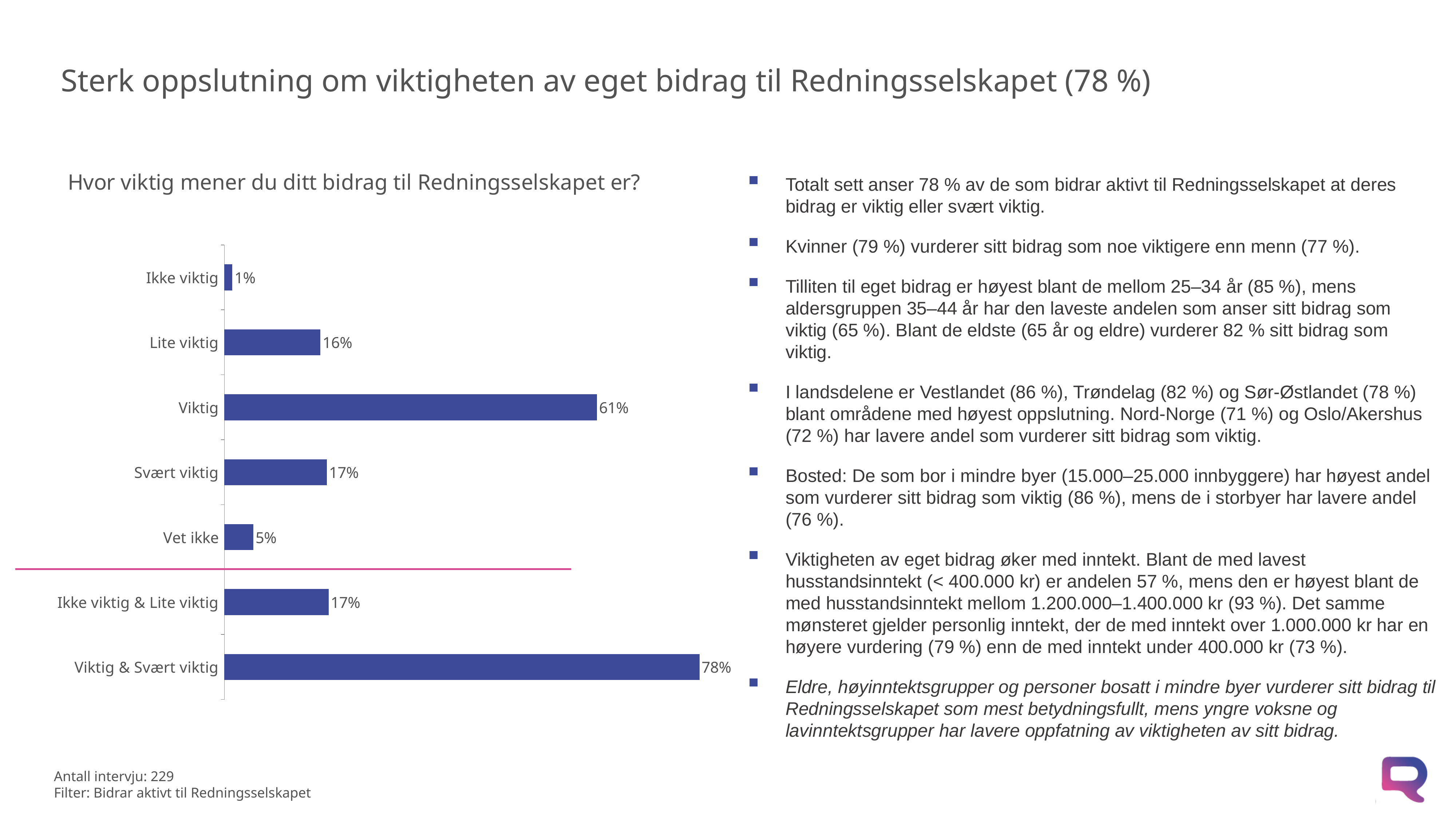
What is the value for "Lite viktig"? 16% What kind of chart is shown on the slide? Bar chart What is the title of the chart? Hvor viktig mener du ditt bidrag til Redningsselskapet er? Which category has the lowest value? Ikke viktig What is the value for "Vet ikke"? 5% What is the difference between the values for "Viktig" and "Svært viktig"? 44% Which category has the highest value? Viktig & Svært viktig What is the difference between the values for "Viktig & Svært viktig" and "Ikke viktig & Lite viktig"? 61% Which is larger, the value for "Lite viktig" or the value for "Vet ikke"? Lite viktig What is the value for "Viktig"? 61% What is the value for "Viktig & Svært viktig"? 78% How many categories are shown in the chart? 7